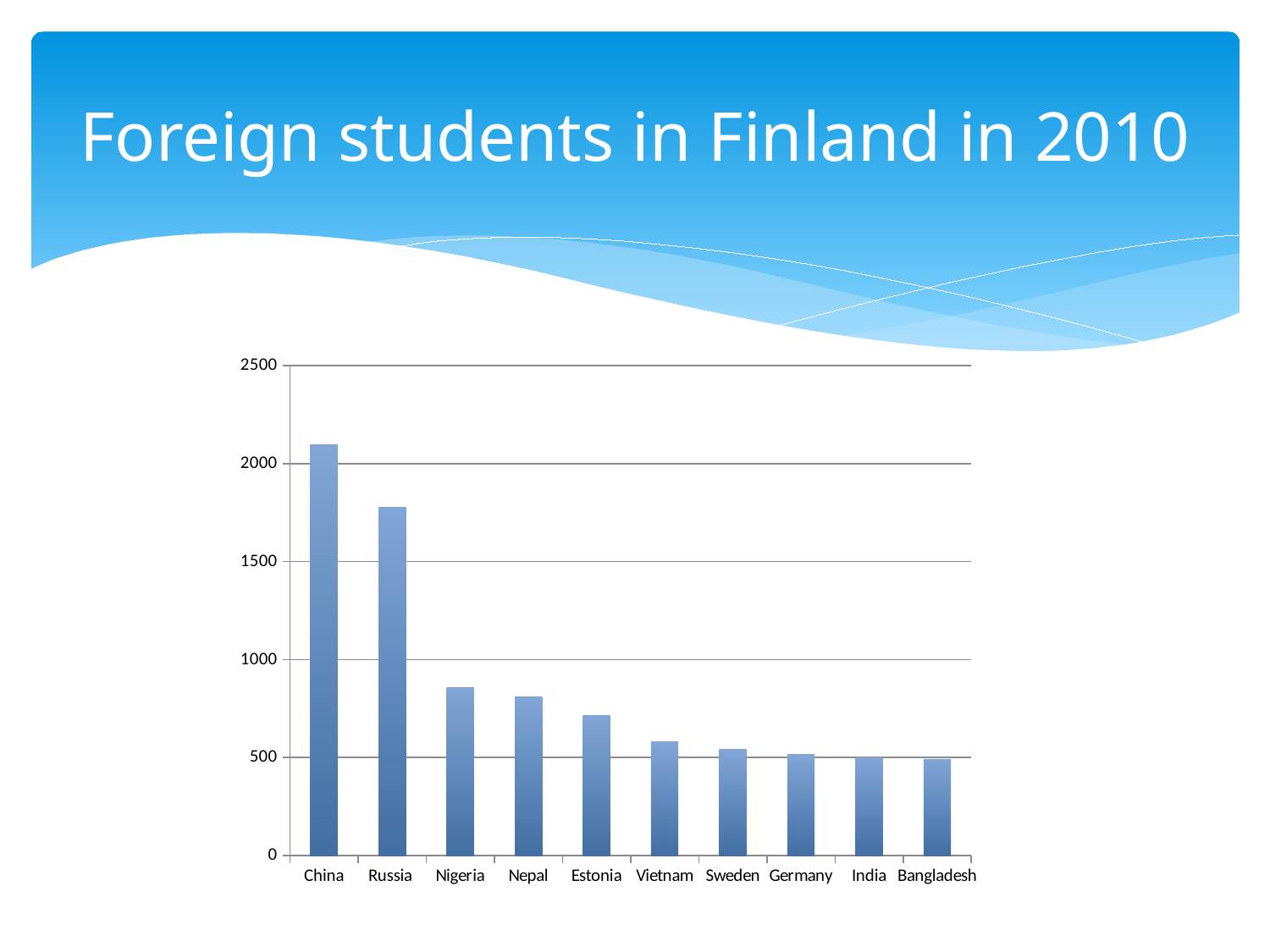
Which country has the highest bar in the chart? China Which is larger, the value for China or the value for Russia? China Is the value for China greater or less than 2000? greater Is the value for Russia greater or less than 1500? greater How many countries are shown on the x axis of the chart? 10 Is the value for Estonia greater or less than 500? greater What is the title of the slide containing the chart? Foreign students in Finland in 2010 Do the bar values rise or fall moving from left to right along the x axis? fall What kind of chart is shown on the slide? bar chart Which is larger, the value for Nigeria or the value for Estonia? Nigeria